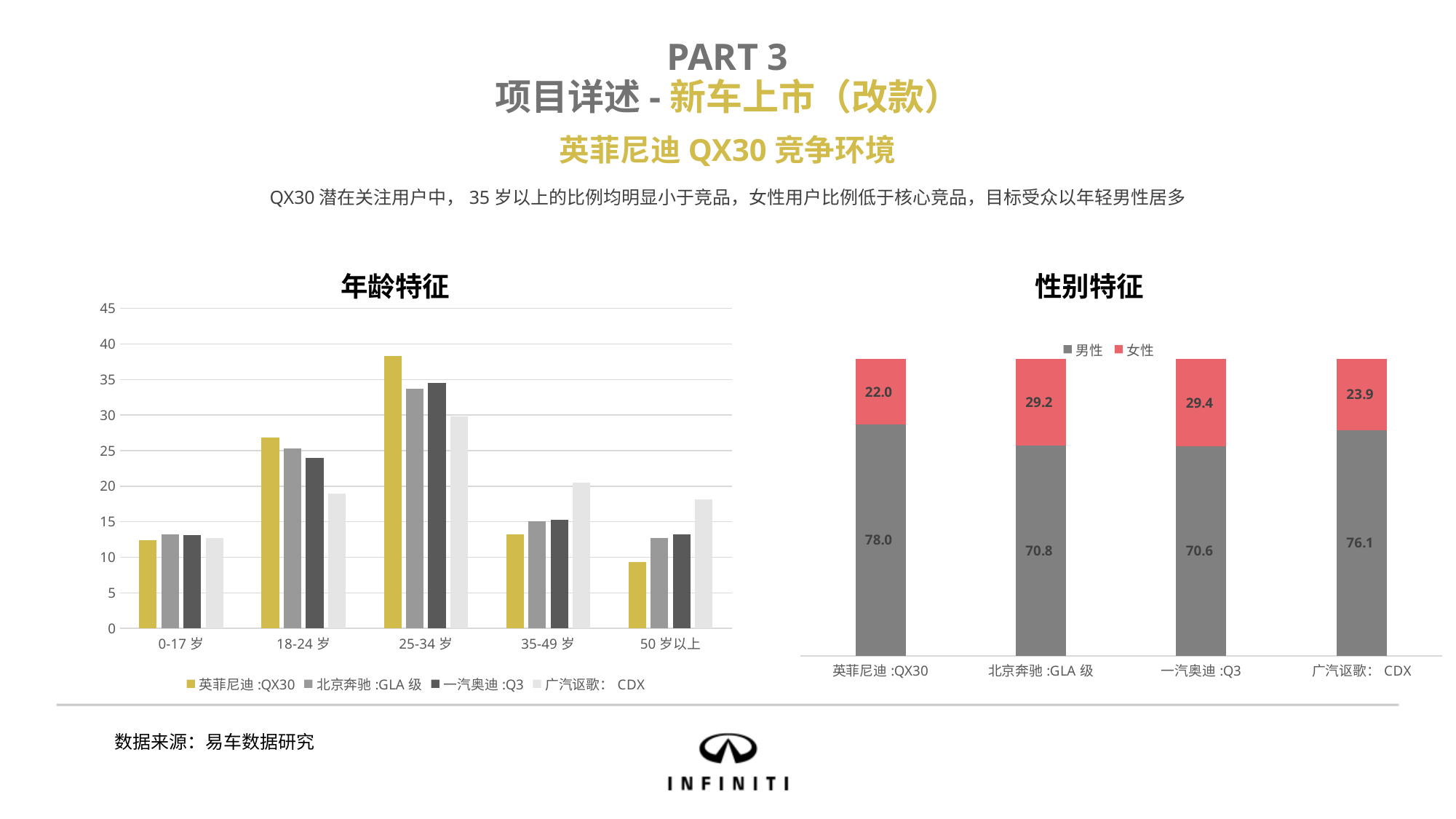
How many age categories are shown on the x axis of the 年龄特征 chart? 5 In the 性别特征 chart, what is the difference between the 男性 and 女性 values for 广汽讴歌: CDX? 52.2 What kind of chart is the 年龄特征 chart? Bar chart In the 性别特征 chart, which car has the lowest 女性 value? 英菲尼迪:QX30 In the 性别特征 chart, what is the 男性 value for 英菲尼迪:QX30? 78.0 In the 性别特征 chart, how many series does the legend list? 2 In the 年龄特征 chart, is the value for 英菲尼迪:QX30 in the 25-34 岁 group greater or less than 35? greater In the 性别特征 chart, what is the 女性 value for 一汽奥迪:Q3? 29.4 In the 年龄特征 chart, which age group has the highest value for 英菲尼迪:QX30? 25-34 岁 In the 性别特征 chart, what is the total of the stacked bar for 北京奔驰:GLA 级? 100.0 In the 年龄特征 chart, is the value for 英菲尼迪:QX30 in the 50 岁以上 group greater or less than 10? less In the 性别特征 chart, which car has the highest 男性 value? 英菲尼迪:QX30